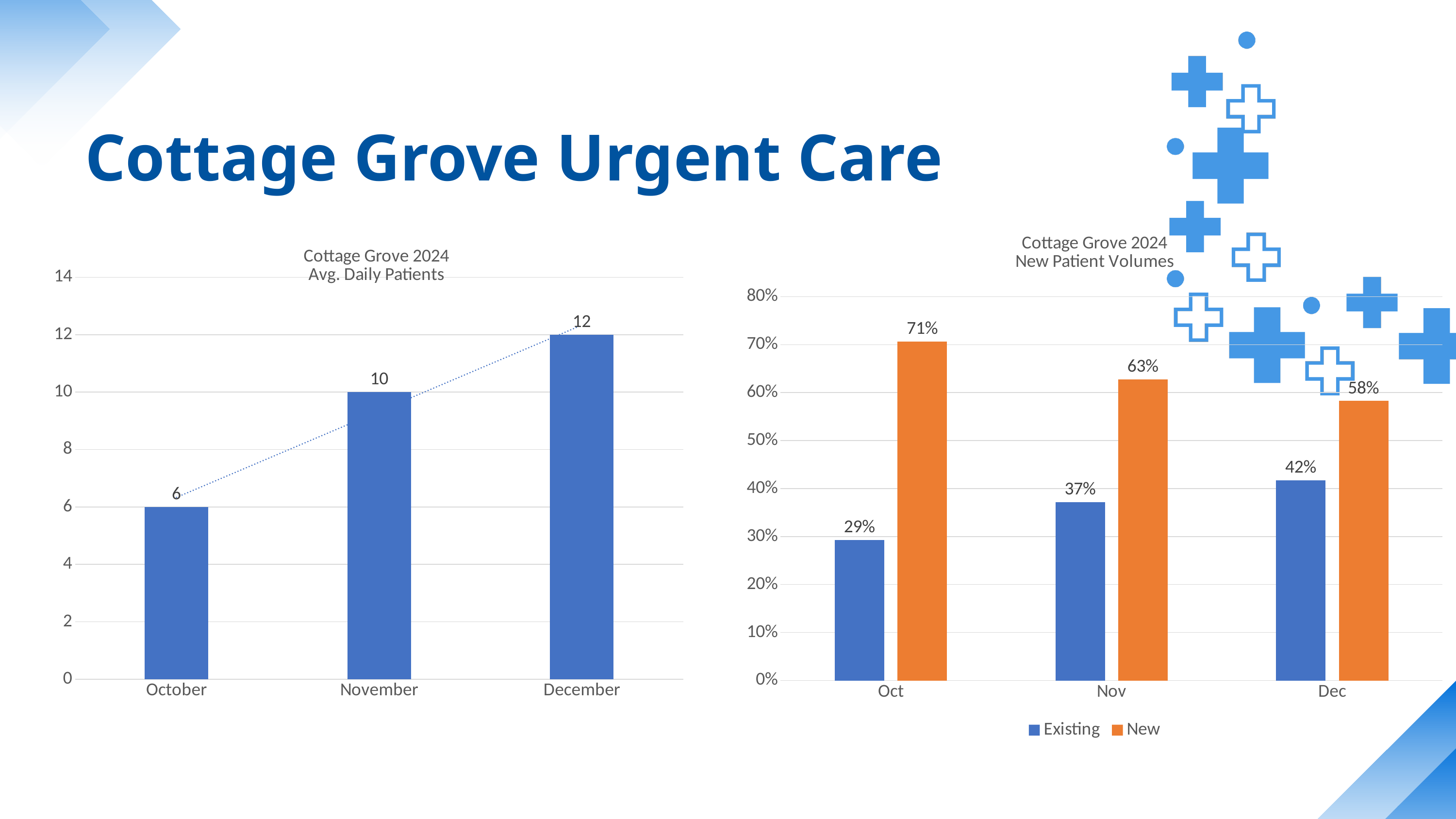
In the 'Cottage Grove 2024 New Patient Volumes' chart, what is the value for New in Oct? 71% In the 'Cottage Grove 2024 Avg. Daily Patients' chart, what is the value for November? 10 In the 'Cottage Grove 2024 New Patient Volumes' chart, how many series does the legend list? 2 What kind of chart is the 'Cottage Grove 2024 New Patient Volumes' chart? bar chart In the 'Cottage Grove 2024 Avg. Daily Patients' chart, do the values rise or fall from October to December? rise In the 'Cottage Grove 2024 Avg. Daily Patients' chart, what is the difference between December and October? 6 In the 'Cottage Grove 2024 Avg. Daily Patients' chart, how many months are shown? 3 In the 'Cottage Grove 2024 New Patient Volumes' chart, what is the difference between New and Existing in Oct? 42% In the 'Cottage Grove 2024 Avg. Daily Patients' chart, which month has the highest value? December In the 'Cottage Grove 2024 Avg. Daily Patients' chart, which month has the lowest value? October In the 'Cottage Grove 2024 New Patient Volumes' chart, which is larger in Nov, Existing or New? New In the 'Cottage Grove 2024 New Patient Volumes' chart, what is the value for Existing in Dec? 42%